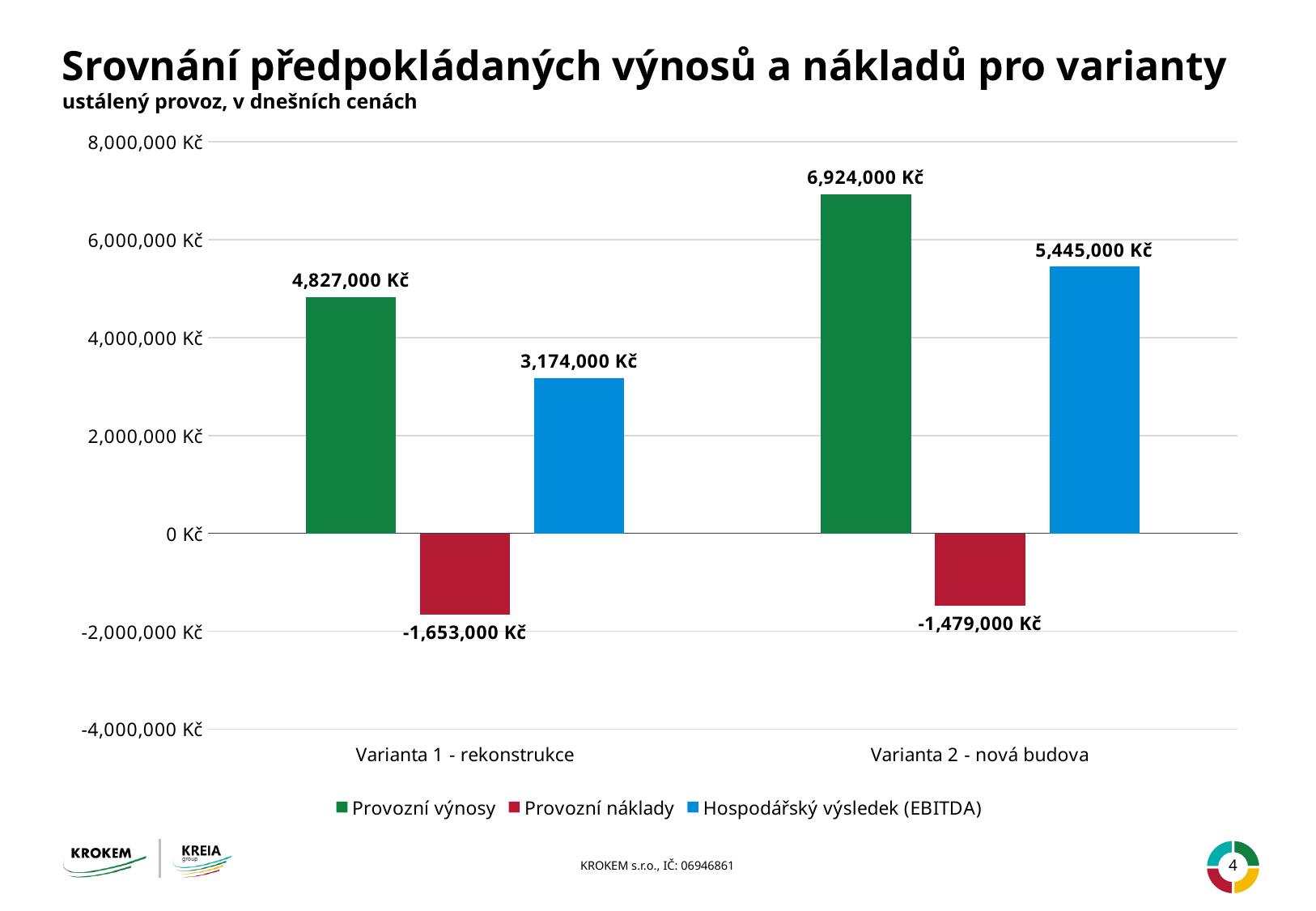
Which variant has the lower Hospodářský výsledek (EBITDA)? Varianta 1 - rekonstrukce Is the Provozní výnosy for Varianta 2 - nová budova greater or less than 6,000,000 Kč? greater What is the value of Provozní náklady for Varianta 2 - nová budova? -1,479,000 Kč What is the Hospodářský výsledek (EBITDA) for Varianta 2 - nová budova? 5,445,000 Kč Which variant has the higher Provozní výnosy? Varianta 2 - nová budova What is the difference in Hospodářský výsledek (EBITDA) between Varianta 2 - nová budova and Varianta 1 - rekonstrukce? 2,271,000 Kč What is the subtitle shown under the chart title? ustálený provoz, v dnešních cenách What is the difference in Provozní výnosy between Varianta 2 - nová budova and Varianta 1 - rekonstrukce? 2,097,000 Kč What is the value of Provozní výnosy for Varianta 1 - rekonstrukce? 4,827,000 Kč What type of chart is shown on the slide? bar chart What is the Hospodářský výsledek (EBITDA) for Varianta 1 - rekonstrukce? 3,174,000 Kč How many series does the legend list? 3